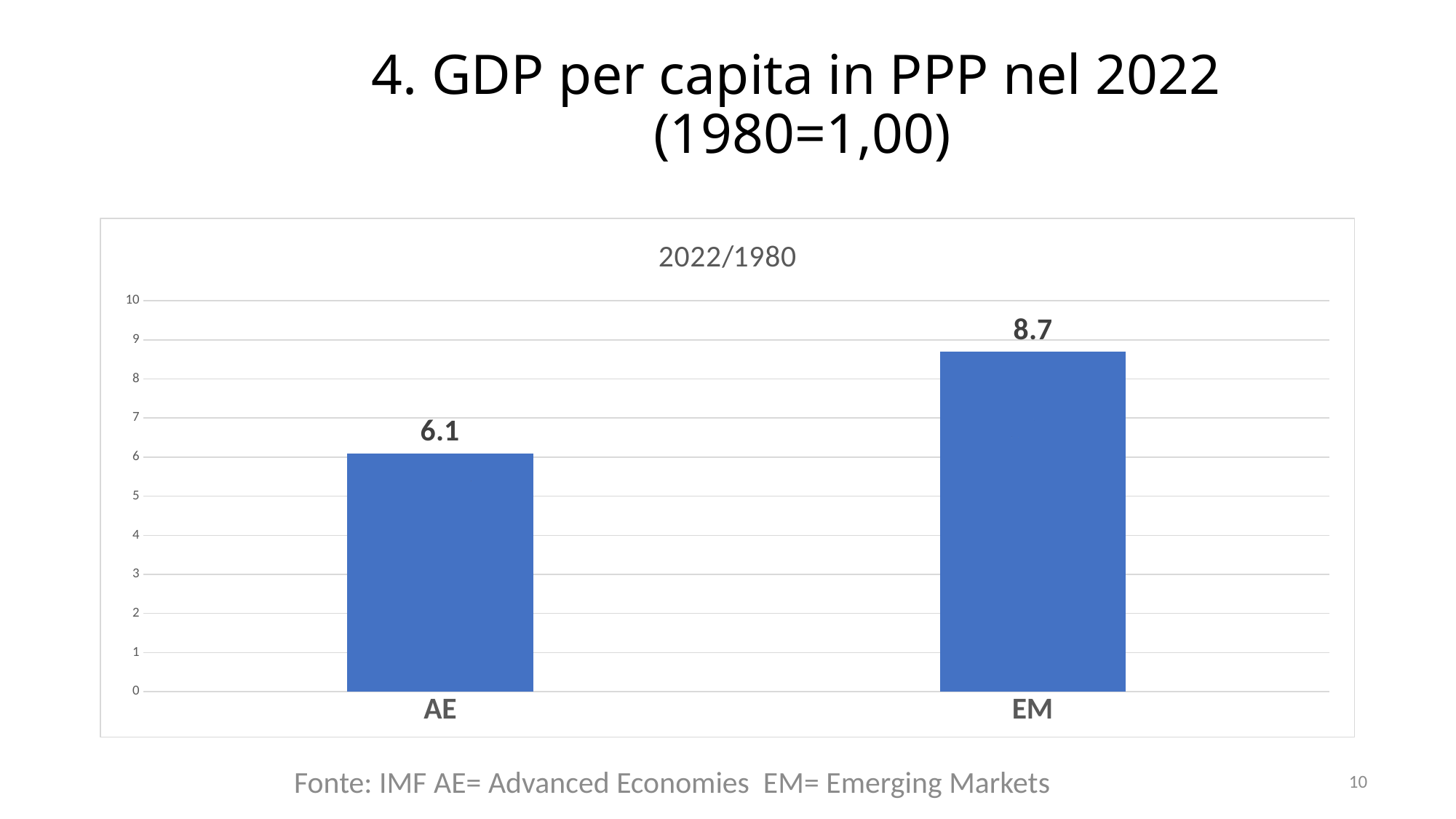
What is the value for EM? 8.7 Which category has the lowest value? AE What is the difference between the values for EM and AE? 2.6 How many categories are shown in the chart? 2 Is the value for AE greater or less than 7? less Which category has the highest value? EM What is the maximum value shown on the vertical axis? 10 Which is larger, the value for AE or the value for EM? EM What is the value for AE? 6.1 Is the value for EM greater or less than 8? greater What kind of chart is shown on the slide? bar chart What is the title of the chart? 2022/1980